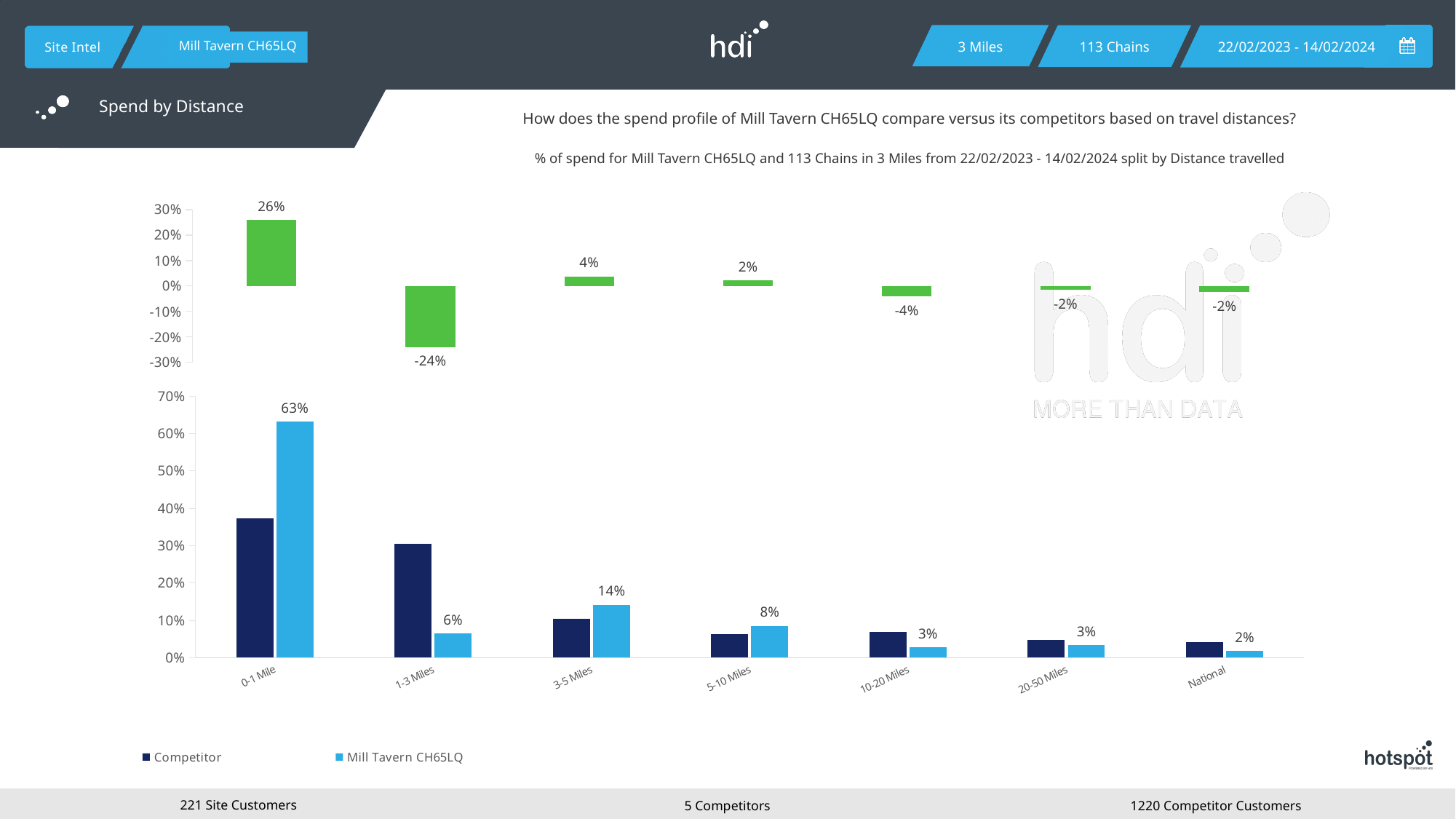
In the bottom chart, at 1-3 Miles, which is larger: the Competitor bar or the Mill Tavern CH65LQ bar? Competitor In the top chart, what is the value shown for 1-3 Miles? -24% In the bottom chart, what is the difference between the Mill Tavern CH65LQ values for 0-1 Mile and 1-3 Miles? 57% In the bottom chart, what is the value for Mill Tavern CH65LQ at 0-1 Mile? 63% In the top chart, which distance band has the lowest value? 1-3 Miles In the top chart, which distance band has the highest value? 0-1 Mile In the bottom chart, what is the value for Mill Tavern CH65LQ at National? 2% What type of chart is the bottom chart? Bar chart How many distance categories are shown on the x axis of the bottom chart? 7 In the bottom chart, is the Competitor value for 0-1 Mile greater or less than 30%? greater In the bottom chart, what is the value for Mill Tavern CH65LQ at 3-5 Miles? 14% How many series does the legend of the bottom chart list? 2